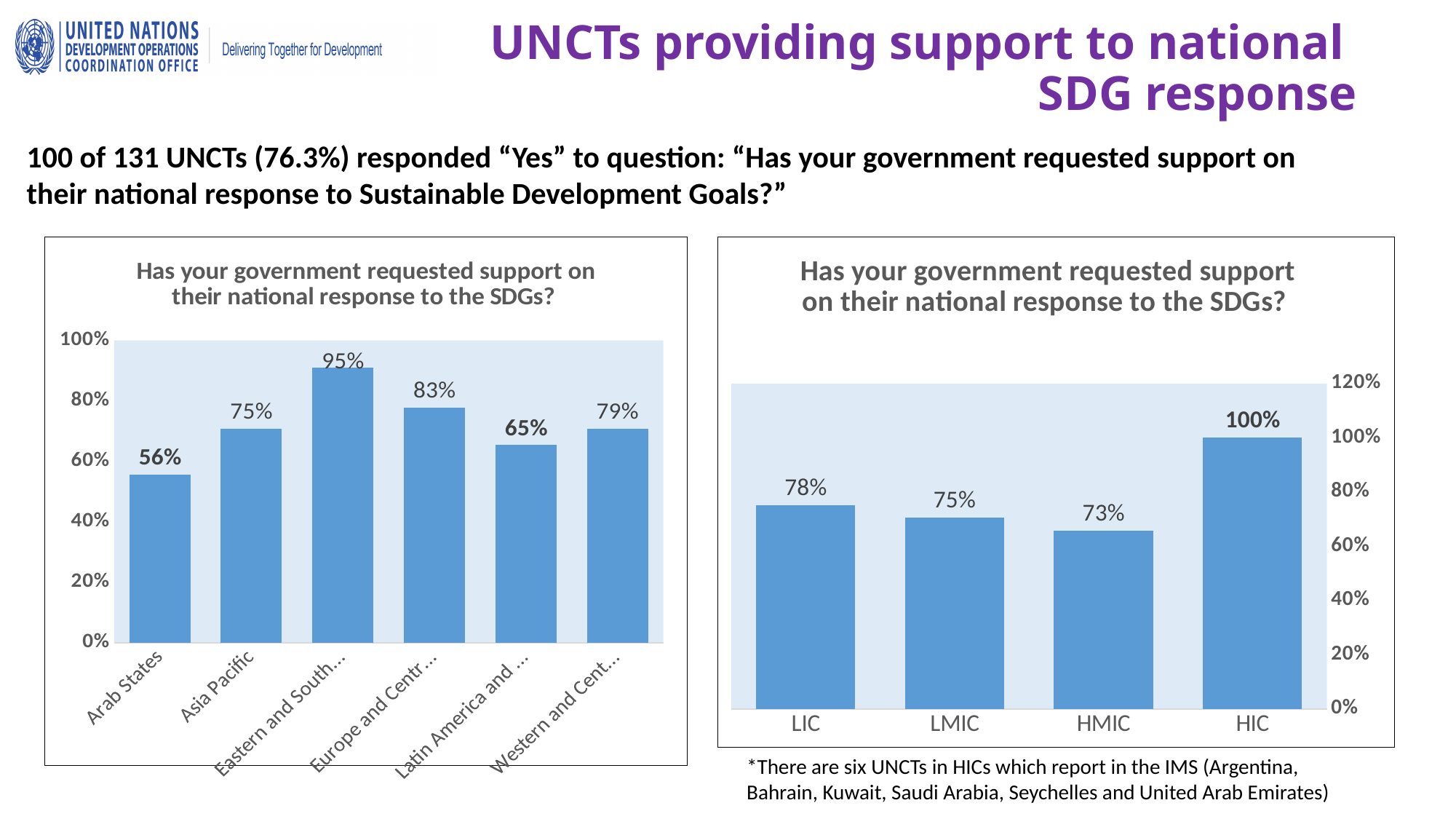
In the left chart (by region), which region has the lowest percentage? Arab States In the left chart (by region), how many regions are plotted? 6 In the right chart (by income group), what is the difference between the values for LIC and LMIC? 3% In the right chart (by income group), what percentage is shown for HIC? 100% In the right chart (by income group), which income group has the highest percentage? HIC In the left chart (by region), what percentage is shown for Asia Pacific? 75% In the right chart (by income group), what percentage is shown for HMIC? 73% What type of chart is the right chart (by income group)? Bar chart In the left chart (by region), what percentage is shown for Arab States? 56% In the right chart (by income group), which income group has the lowest percentage? HMIC In the right chart (by income group), which is larger, the value for LIC or the value for HMIC? LIC In the left chart (by region), what is the difference between the values for Asia Pacific and Arab States? 19%